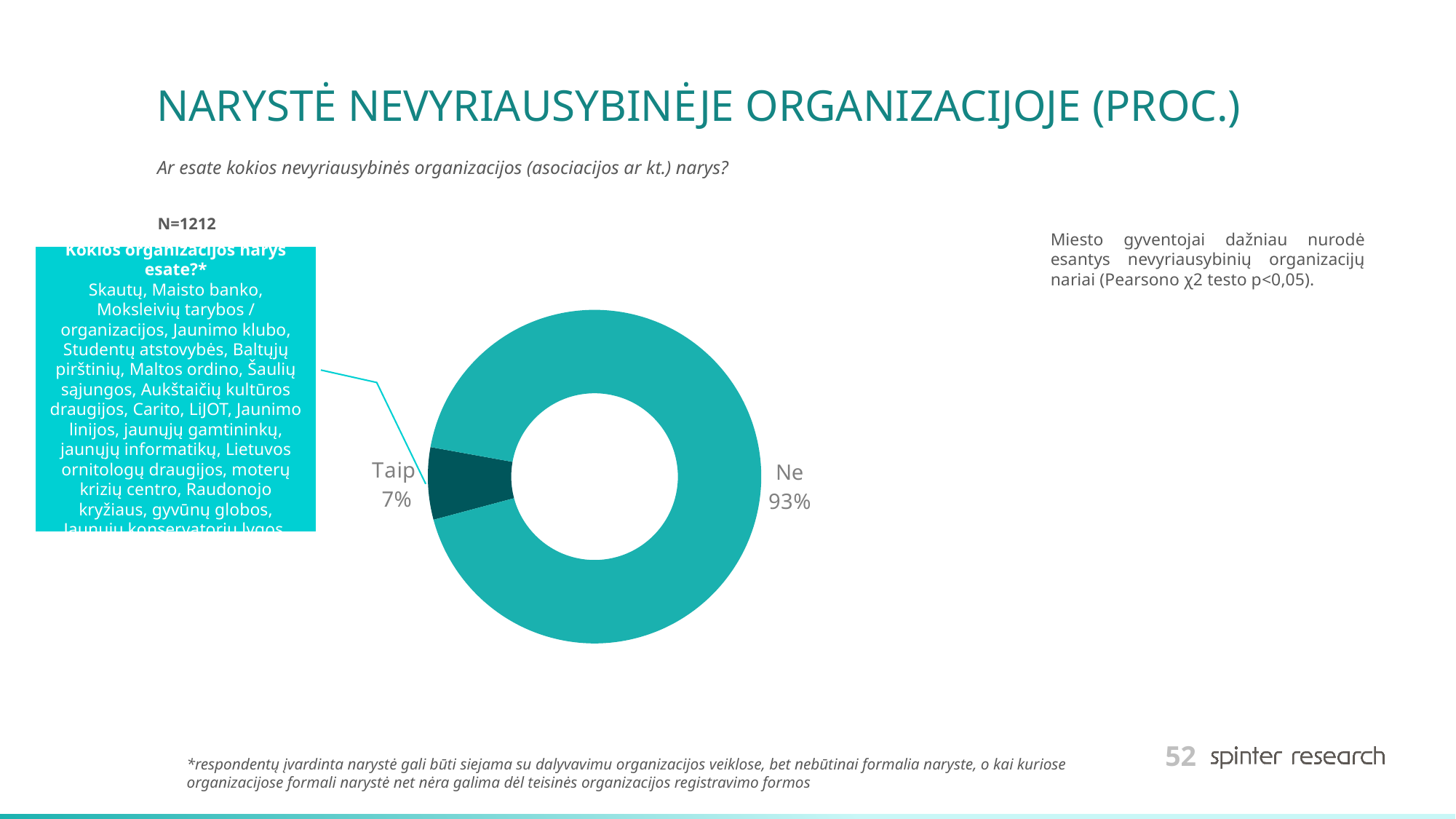
What is the title of the slide? NARYSTĖ NEVYRIAUSYBINĖJE ORGANIZACIJOJE (PROC.) What percentage of respondents answered "Ne"? 93% Which category has the smallest share of the chart? Taip What is the difference in percentage points between "Ne" and "Taip"? 86 Which category has the largest share of the chart? Ne What is the sample size (N) stated on the slide? N=1212 Which is larger, the share for "Taip" or the share for "Ne"? Ne What percentage of respondents answered "Taip"? 7% What kind of chart is shown on the slide? Doughnut chart How many categories are shown in the chart? 2